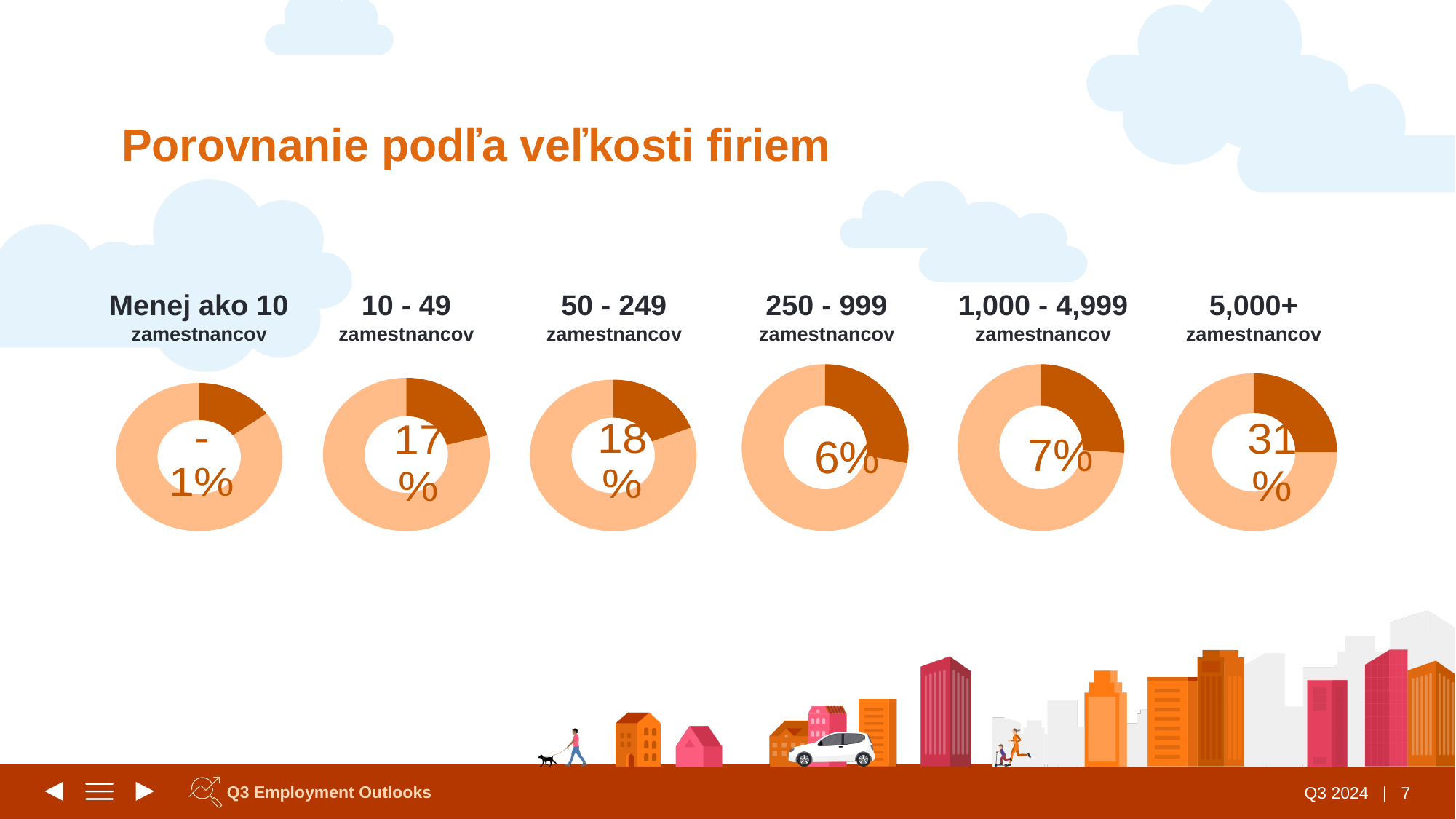
Which is larger: the value on the 50 - 249 zamestnancov donut chart or the value on the 1,000 - 4,999 zamestnancov donut chart? 50 - 249 zamestnancov On the donut chart for 10 - 49 zamestnancov, what value is shown in the centre? 17% On the donut chart for 50 - 249 zamestnancov, what value is shown in the centre? 18% Across the six donut charts, which company-size category shows the lowest value? Menej ako 10 zamestnancov On the donut chart for Menej ako 10 zamestnancov, what value is shown in the centre? -1% On the donut chart for 250 - 999 zamestnancov, what value is shown in the centre? 6% On the donut chart for 5,000+ zamestnancov, what value is shown in the centre? 31% What is the difference between the value on the 5,000+ zamestnancov donut chart and the value on the 250 - 999 zamestnancov donut chart? 25% On the donut chart for 1,000 - 4,999 zamestnancov, what value is shown in the centre? 7% What kind of chart is used for each company-size category on the slide? Donut chart How many donut charts are shown on the slide? 6 Across the six donut charts, which company-size category shows the highest value? 5,000+ zamestnancov